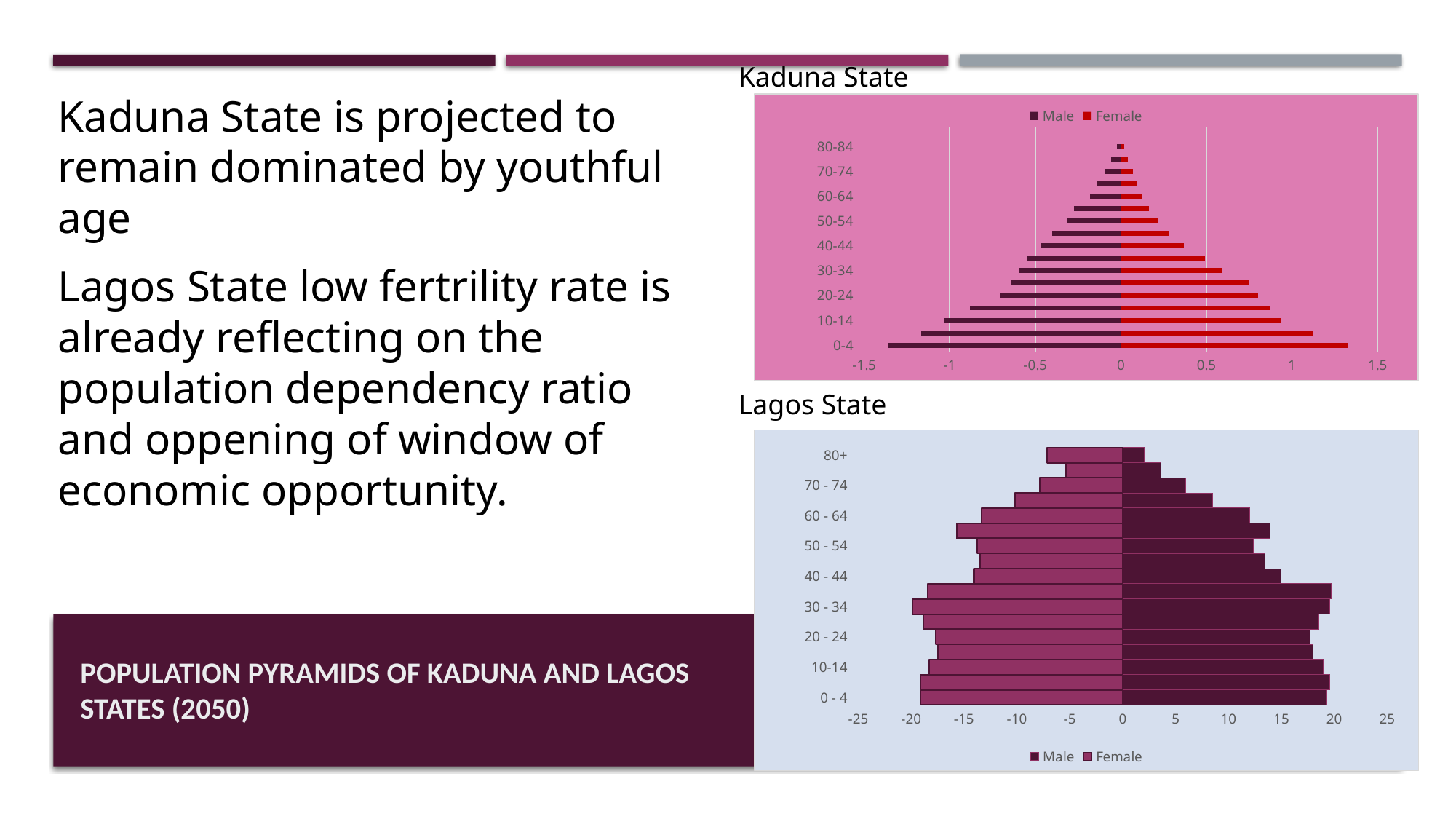
In the Kaduna State chart, is the Female value for the 40-44 age group greater or less than 0.5? less In the Lagos State chart, is the Male value for the 30 - 34 age group greater or less than 15? greater How many series does the legend of the Lagos State chart list? 2 In the Kaduna State chart, which labelled age group has the smallest Female bar? 80-84 How many series does the legend of the Kaduna State chart list? 2 In the Kaduna State chart, which age group has the largest Female bar? 0-4 In the Kaduna State chart, is the Female value for the 0-4 age group greater or less than 1? greater In the Kaduna State chart, do the Female bars get longer or shorter as the age group increases from 0-4 to 80-84? shorter In the Lagos State chart, which is larger, the Male value for 30 - 34 or the Male value for 70 - 74? 30 - 34 What are the two legend entries in the Lagos State chart? Male and Female What kind of chart is the Kaduna State chart? bar chart